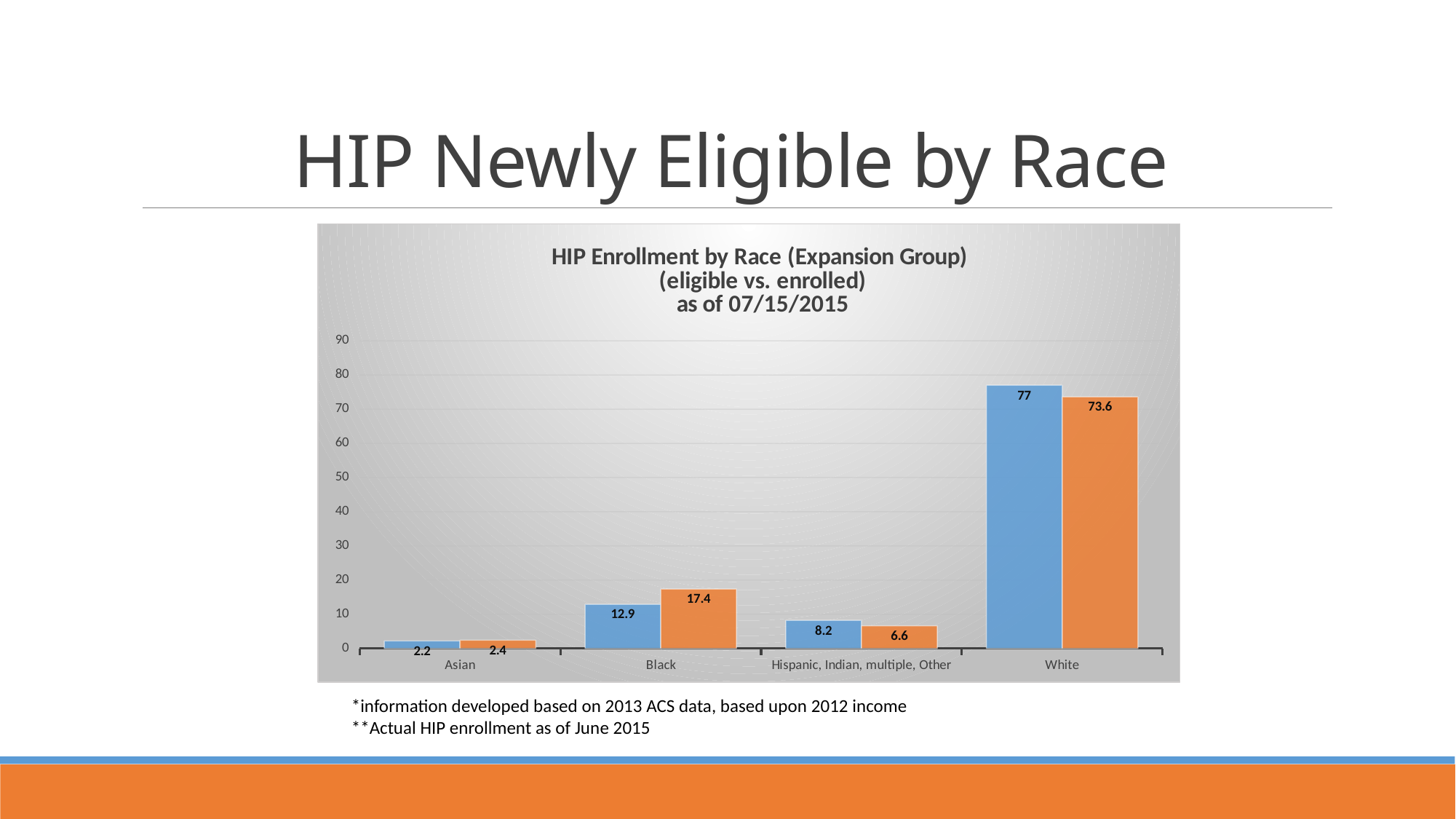
What is the value of the blue bar for Hispanic, Indian, multiple, Other? 8.2 Which category has the highest blue bar? White Which category has the lowest orange bar? Asian What is the difference between the blue and orange bars for White? 3.4 For Hispanic, Indian, multiple, Other, which bar is larger, blue or orange? blue What is the value of the orange bar for White? 73.6 What is the difference between the blue and orange bars for Black? 4.5 What is the value of the orange bar for Asian? 2.4 What is the value of the blue bar for Black? 12.9 Is the value of the blue bar for White greater or less than 70? greater What kind of chart is shown on the slide? bar chart How many race categories are shown on the x axis? 4